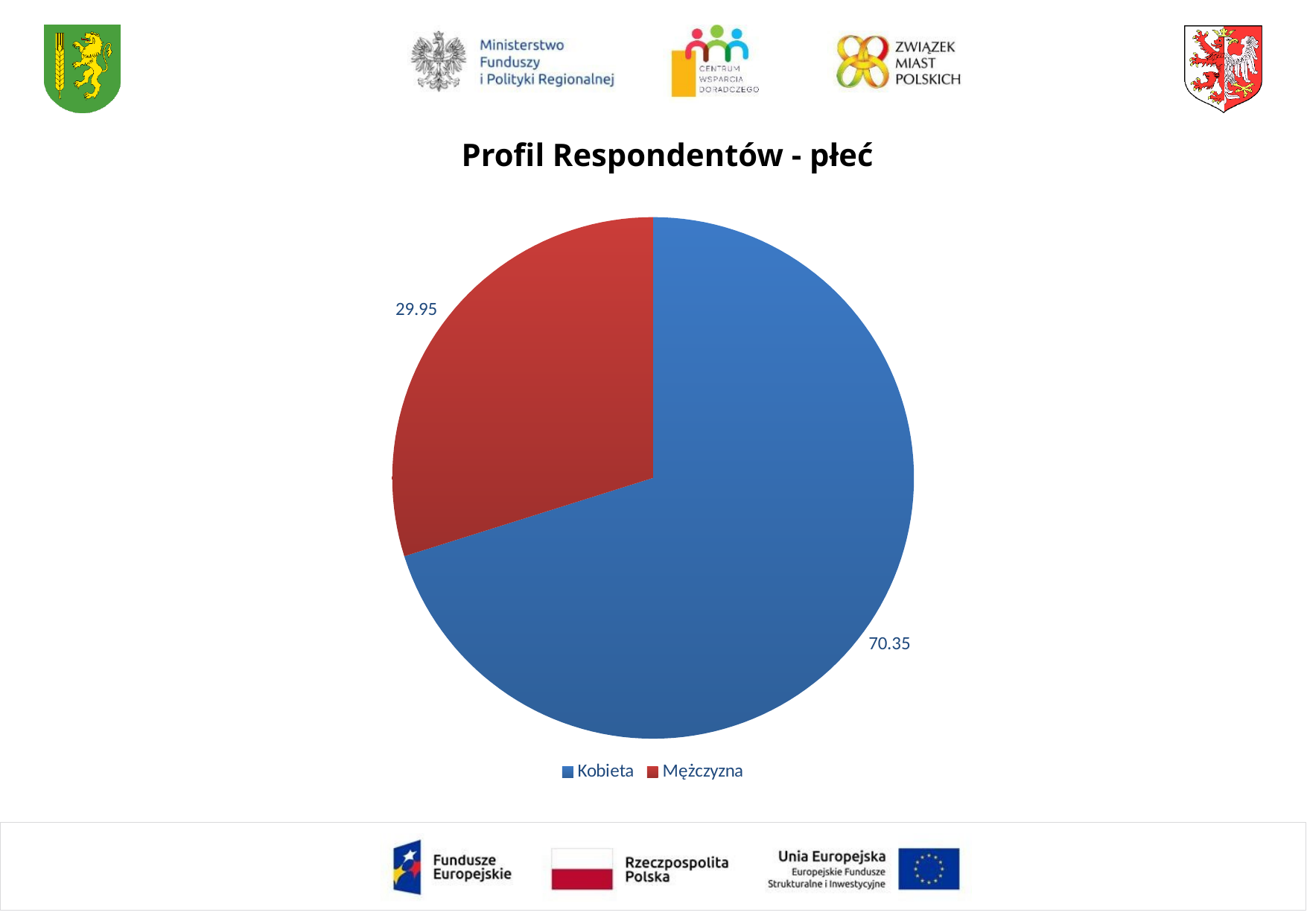
Which category has the smallest slice? Mężczyzna What kind of chart is shown on the slide? Pie chart Which is larger, the value for Kobieta or the value for Mężczyzna? Kobieta Which category has the largest slice? Kobieta What is the difference between the values for Kobieta and Mężczyzna? 40.4 What colour is the slice for Mężczyzna? Red What is the value for Mężczyzna? 29.95 How many slices does the pie chart have? 2 What is the title of the chart? Profil Respondentów - płeć What is the value for Kobieta? 70.35